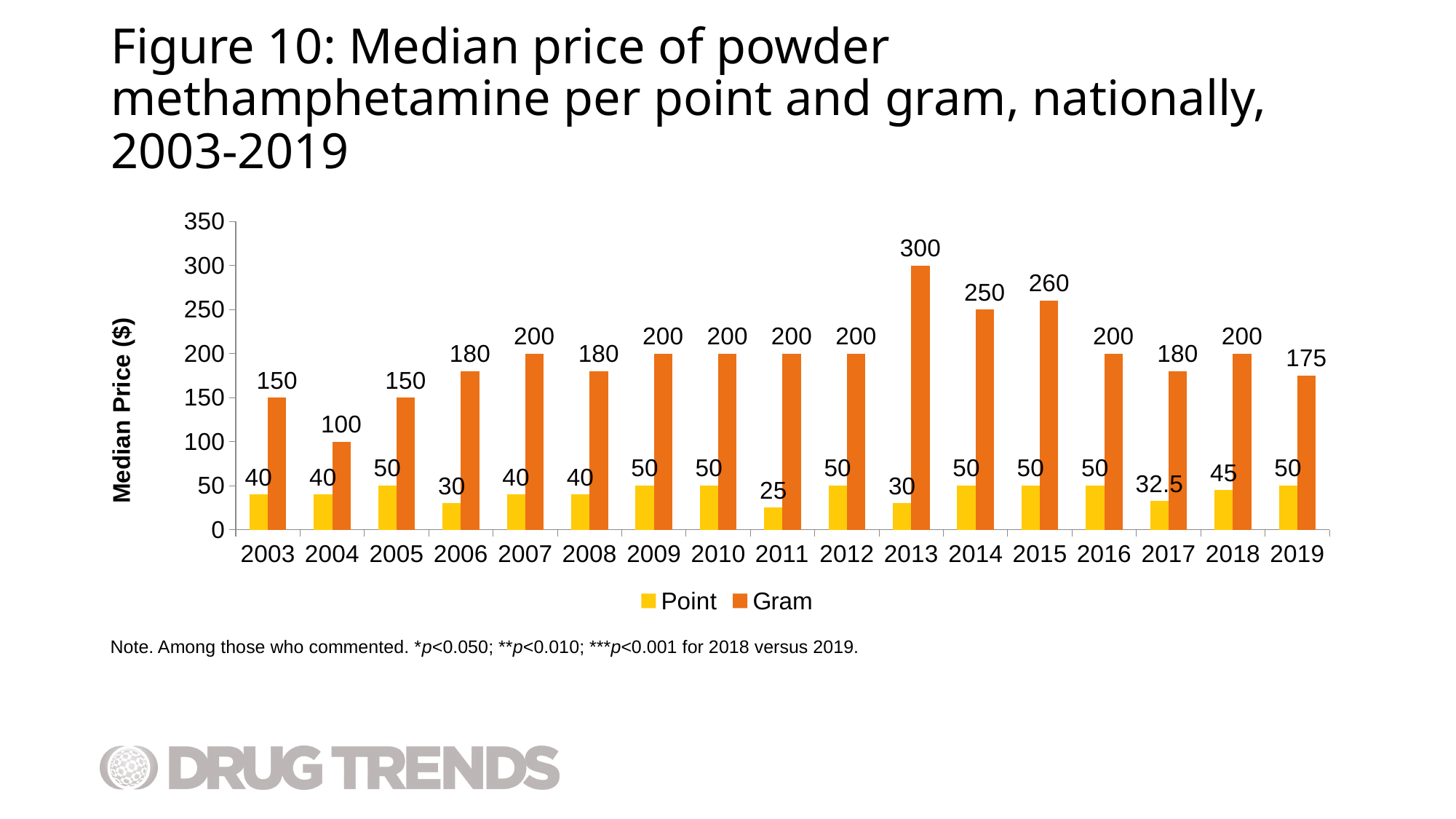
How many years are shown on the x axis? 17 What kind of chart is shown on the slide? Bar chart What is the difference between the median price per gram and per point in 2019? 125 Which year has the highest median price per gram? 2013 Which year has the lowest median price per gram? 2004 How many series does the legend list? 2 Which year has the lowest median price per point? 2011 Which is larger, the median price per gram in 2018 or in 2019? 2018 What is the difference between the median price per gram in 2015 and in 2014? 10 What is the median price per gram in 2019? 175 What is the median price per point in 2017? 32.5 What is the median price per gram in 2013? 300